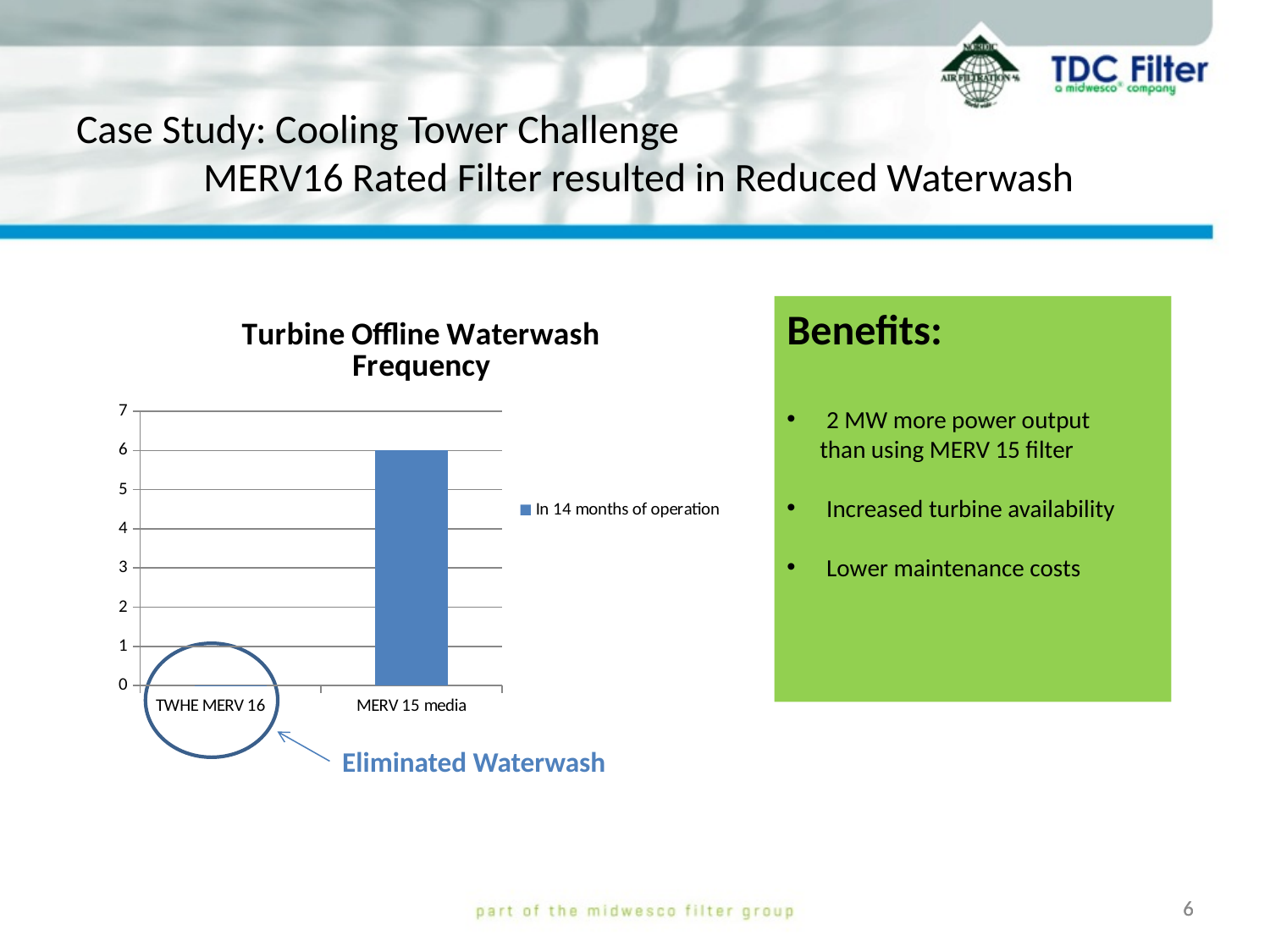
How many series does the chart's legend list? 1 Is the value for MERV 15 media greater or less than 4? greater How many categories are shown on the x axis of the chart? 2 What is the legend entry for the series in the chart? In 14 months of operation What is the title of the chart? Turbine Offline Waterwash Frequency What kind of chart is shown on the slide? bar chart What is the value for TWHE MERV 16 in the chart? 0 Which is larger, the value for TWHE MERV 16 or the value for MERV 15 media? MERV 15 media Which category has the highest value in the chart? MERV 15 media What is the difference between the value for MERV 15 media and the value for TWHE MERV 16? 6 What is the value for MERV 15 media in the chart? 6 Which category has the lowest value in the chart? TWHE MERV 16